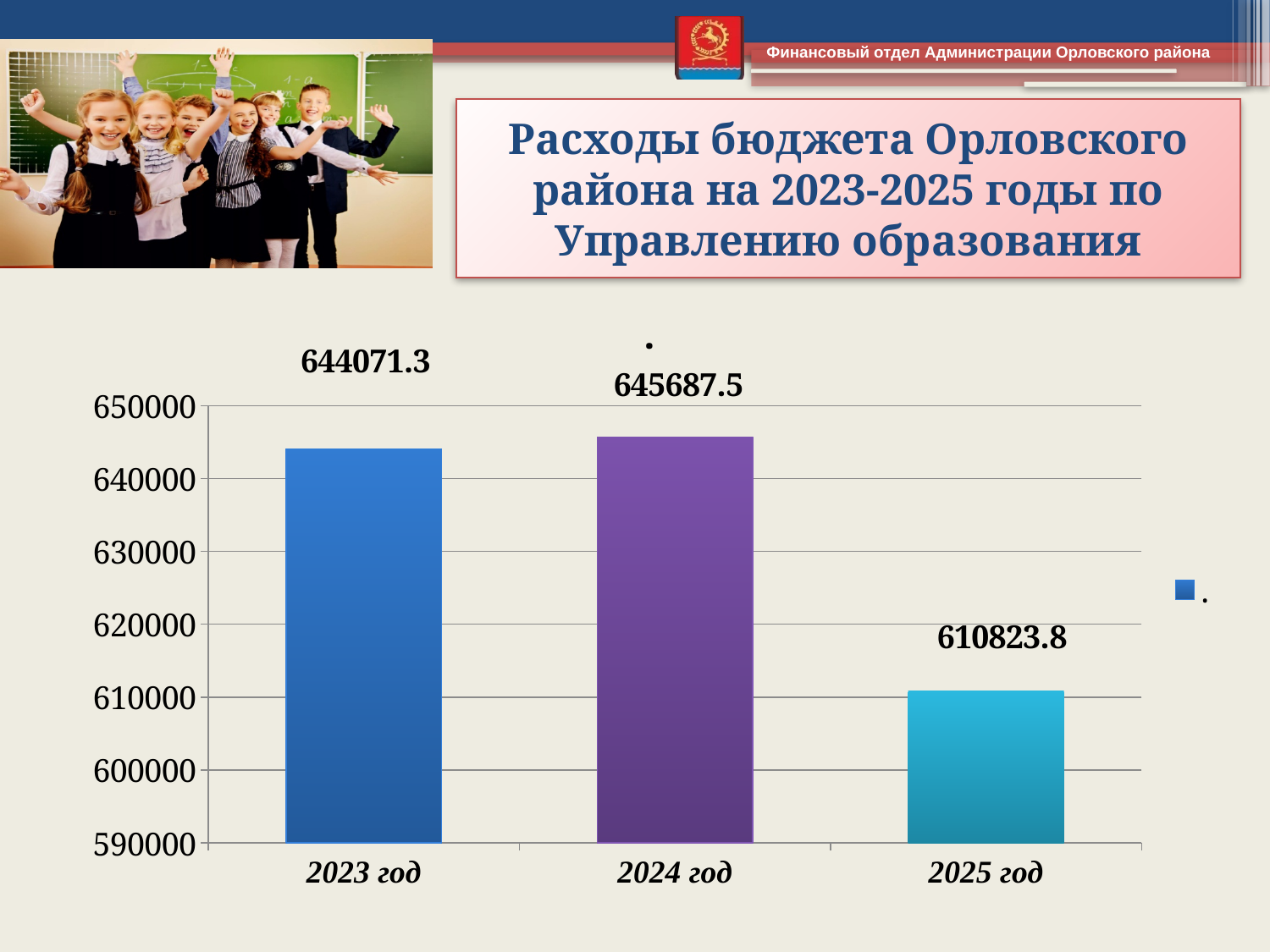
Which year has the lowest value? 2025 год Which is larger, the value for 2023 год or the value for 2025 год? 2023 год What is the value shown for 2024 год? 645687.5 Do the values rise or fall from 2024 год to 2025 год? fall What is the value shown for 2025 год? 610823.8 What is the difference between the values for 2024 год and 2023 год? 1616.2 Which year has the highest value? 2024 год What is the difference between the values for 2023 год and 2025 год? 33247.5 Is the value for 2025 год greater or less than 620000? less How many years are shown on the chart? 3 What kind of chart is shown on the slide? bar chart What is the value shown for 2023 год? 644071.3